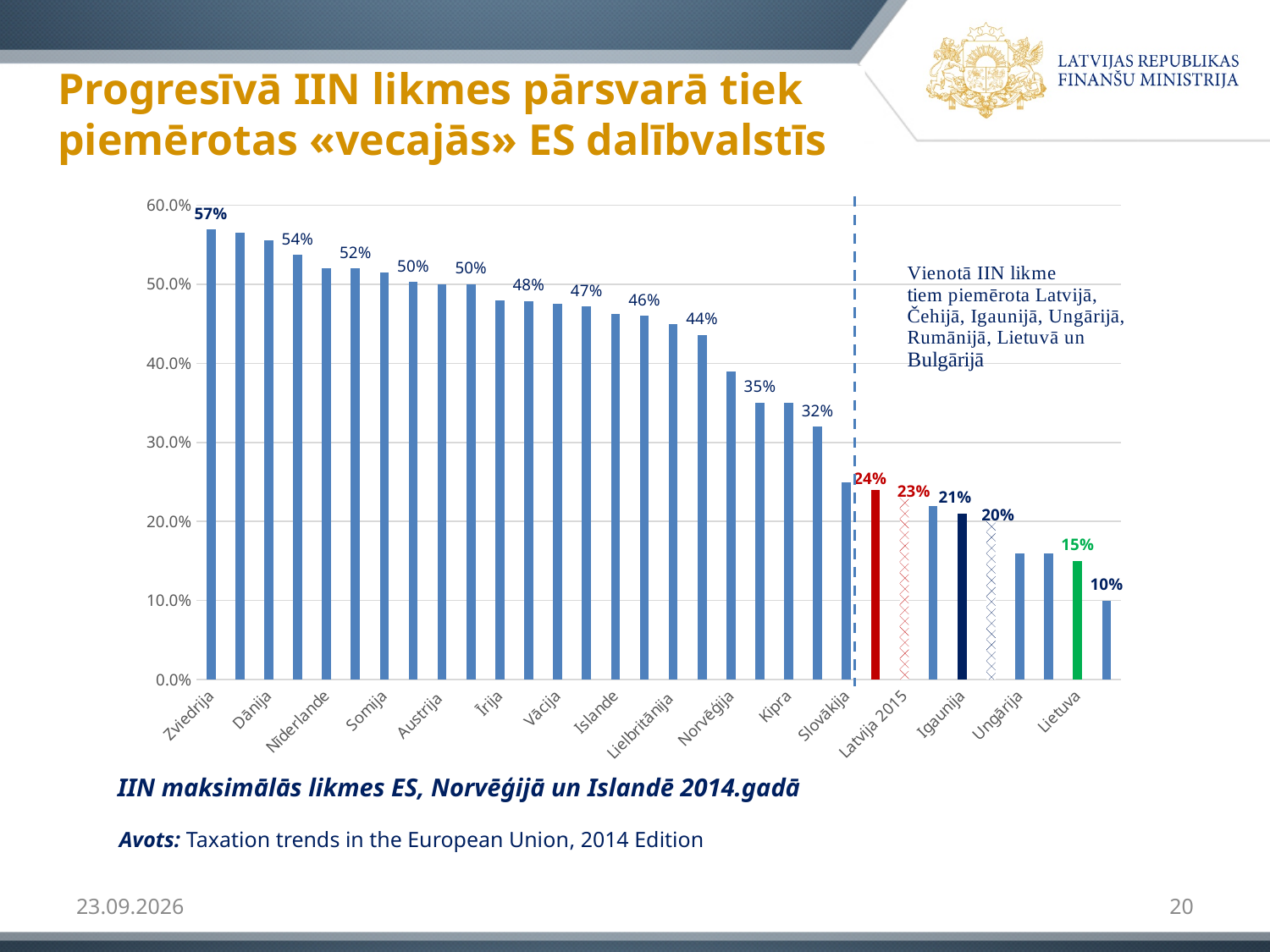
Is the value for Kipra greater or less than 30.0%? greater What is the value for Igaunija? 21% Is the value for Slovākija greater or less than 30.0%? less Which is larger, the value for Igaunija or the value for Lietuva? Igaunija What is the value for Latvija 2015? 23% Do the values generally rise or fall from left to right along the x axis? fall What is the value for Lietuva? 15% What is the lowest value shown in the chart? 10% What is the difference between the values for Latvija 2015 and Lietuva? 8 percentage points What kind of chart is shown on the slide? bar chart What is the value for Zviedrija? 57% Which country has the highest maximum IIN rate in the chart? Zviedrija